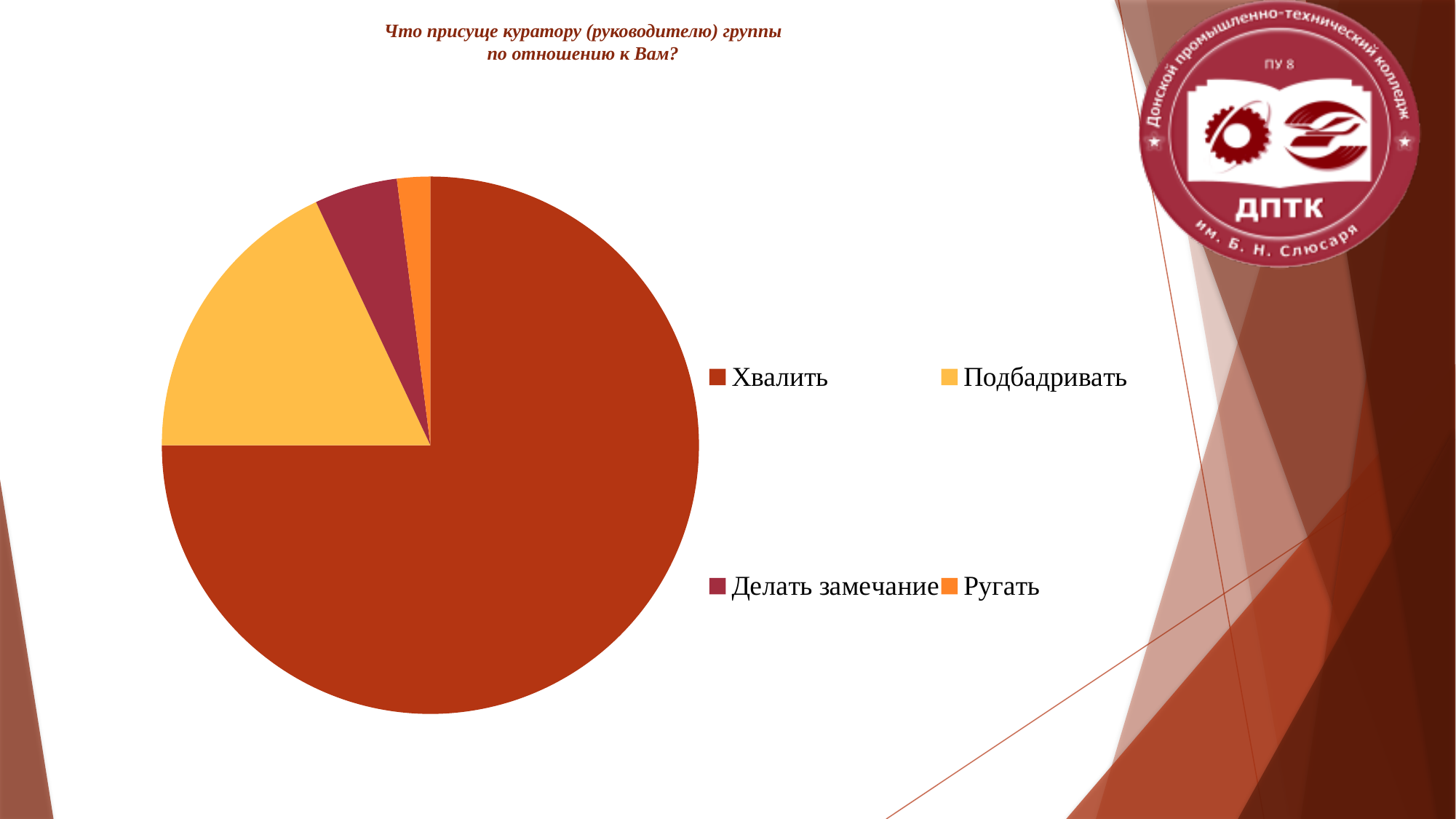
How many entries does the legend of the pie chart list? 4 Which category has the largest slice of the pie chart? Хвалить Which slice is larger, Подбадривать or Делать замечание? Подбадривать Which slice is larger, Делать замечание or Ругать? Делать замечание What is the title of the chart on the slide? Что присуще куратору (руководителю) группы по отношению к Вам? Which slice is larger, Хвалить or Подбадривать? Хвалить How many categories (slices) does the pie chart have? 4 What kind of chart is shown on the slide? pie chart Which category has the smallest slice of the pie chart? Ругать Which legend entry is shown in yellow? Подбадривать